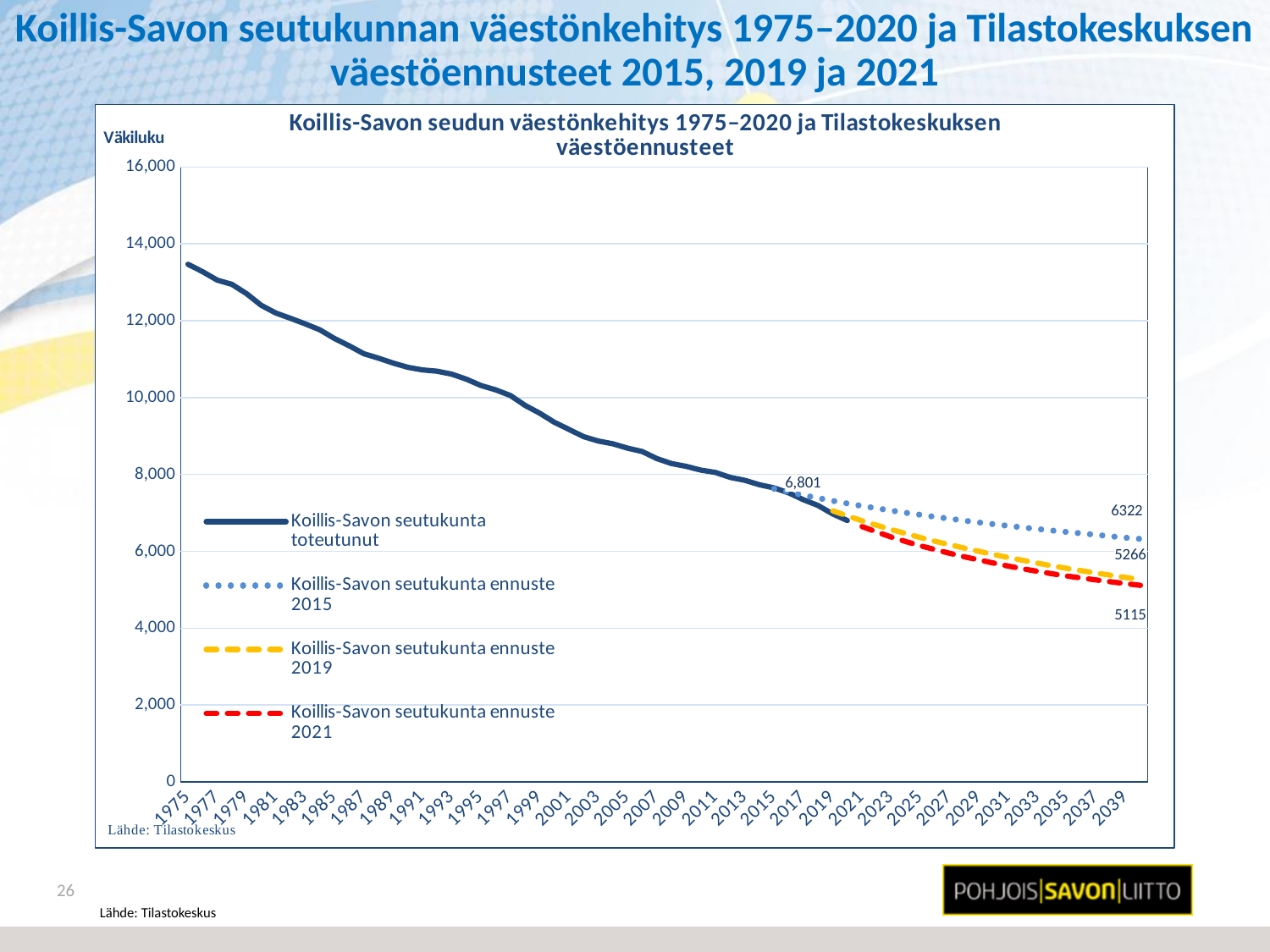
What kind of chart is shown on the slide? line chart What is the difference between the final labelled values of the ennuste 2015 line (6322) and the ennuste 2021 line (5115)? 1207 Does the Koillis-Savon seutukunta toteutunut line rise or fall from 1975 to 2020? fall Which forecast series ends at the highest labelled value? Koillis-Savon seutukunta ennuste 2015 Which forecast series ends at the lowest labelled value? Koillis-Savon seutukunta ennuste 2021 What is the final labelled value of the Koillis-Savon seutukunta ennuste 2021 line? 5115 What is the label on the vertical axis of the chart? Väkiluku What value is labelled at the end of the Koillis-Savon seutukunta toteutunut line? 6,801 What is the final labelled value of the Koillis-Savon seutukunta ennuste 2015 line? 6322 Is the value of the Koillis-Savon seutukunta toteutunut line in 1975 greater or less than 12,000? greater What is the final labelled value of the Koillis-Savon seutukunta ennuste 2019 line? 5266 How many series does the chart legend list? 4